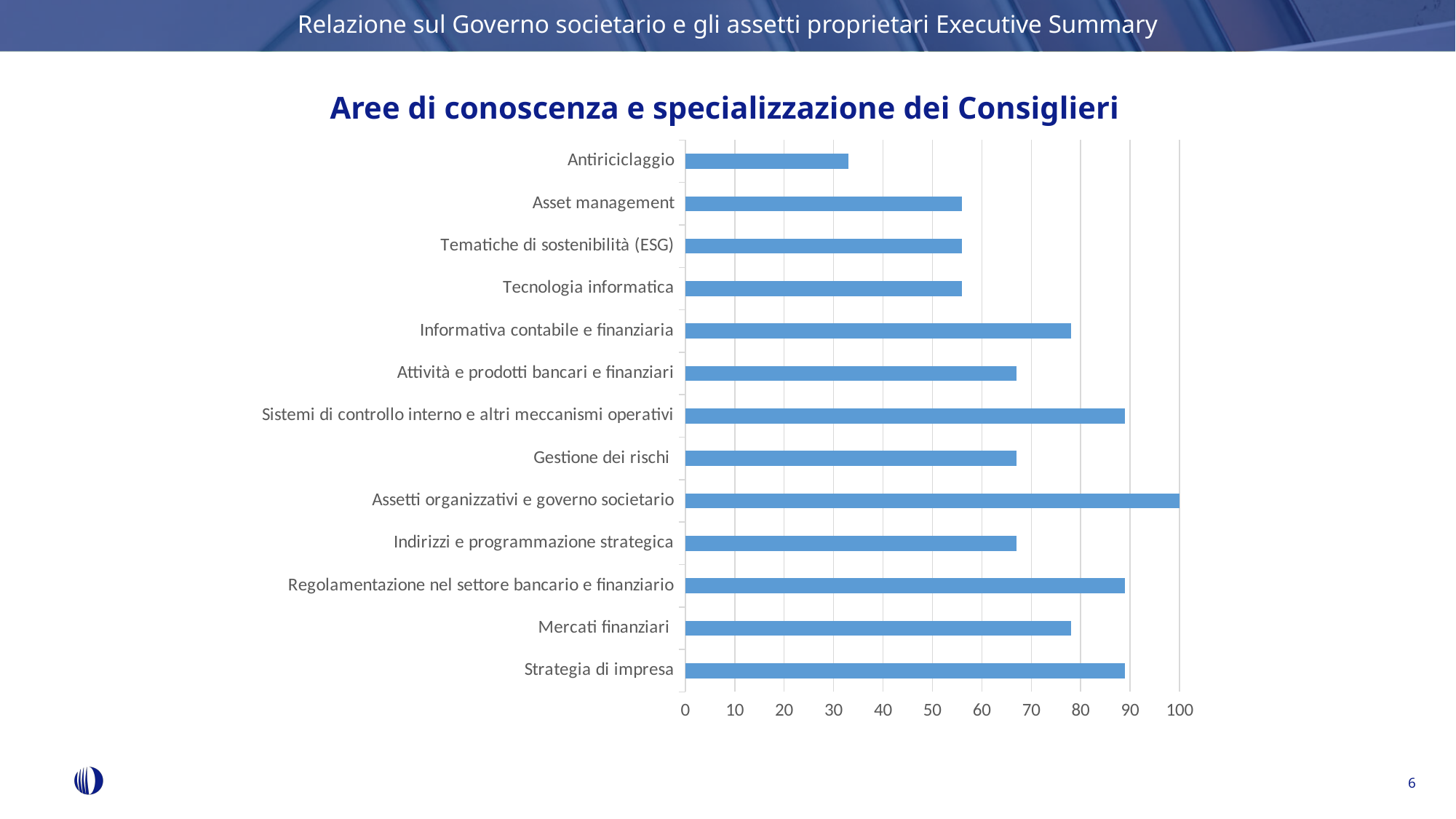
Is the value for Antiriciclaggio greater or less than 40? less Is the value for Asset management greater or less than 60? less Is the value for Strategia di impresa greater or less than 80? greater Which category has the highest value? Assetti organizzativi e governo societario Which category has the lowest value? Antiriciclaggio Which is larger, the value for Informativa contabile e finanziaria or the value for Attività e prodotti bancari e finanziari? Informativa contabile e finanziaria What is the value for Assetti organizzativi e governo societario? 100 Which is larger, the value for Antiriciclaggio or the value for Tecnologia informatica? Tecnologia informatica What kind of chart is shown on the slide? bar chart How many categories are plotted in the chart? 13 What is the title of the chart? Aree di conoscenza e specializzazione dei Consiglieri